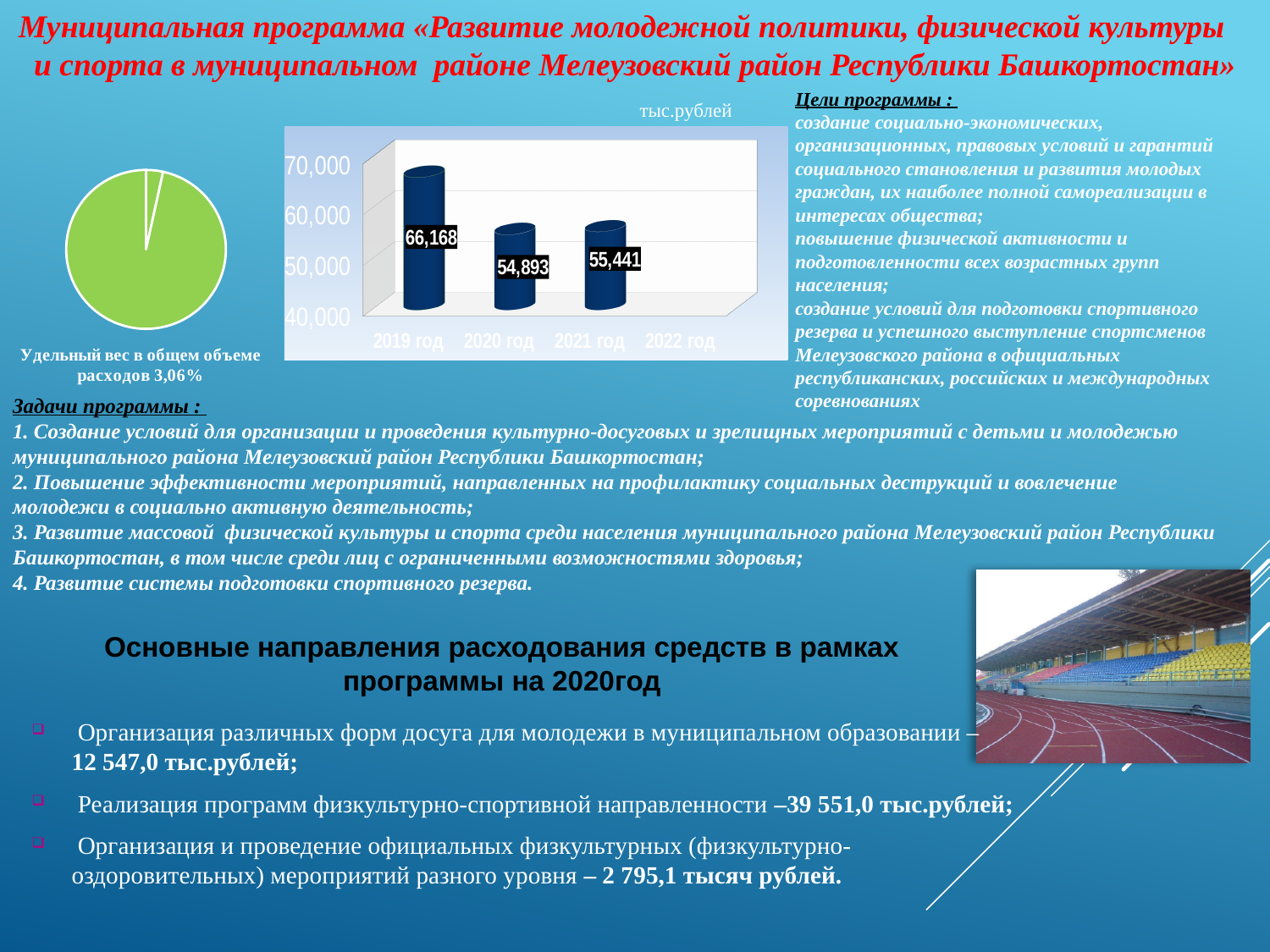
In the bar chart, which of the labelled bars has the lowest value? 2020 год In the bar chart, how many year categories are labelled on the x axis? 4 In the bar chart, what is the value for 2019 год? 66,168 In the bar chart, what is the difference between the values for 2019 год and 2020 год? 11,275 What kind of chart is the chart on the left side of the slide? pie chart In the bar chart, what is the difference between the values for 2021 год and 2020 год? 548 In the bar chart, what is the value for 2021 год? 55,441 In the bar chart, which year has the highest value? 2019 год In the bar chart, what unit is shown above the chart? тыс.рублей In the bar chart, what is the value for 2020 год? 54,893 In the bar chart, is the value for 2019 год greater or less than 60,000? greater In the bar chart, which is larger, the value for 2020 год or 2021 год? 2021 год